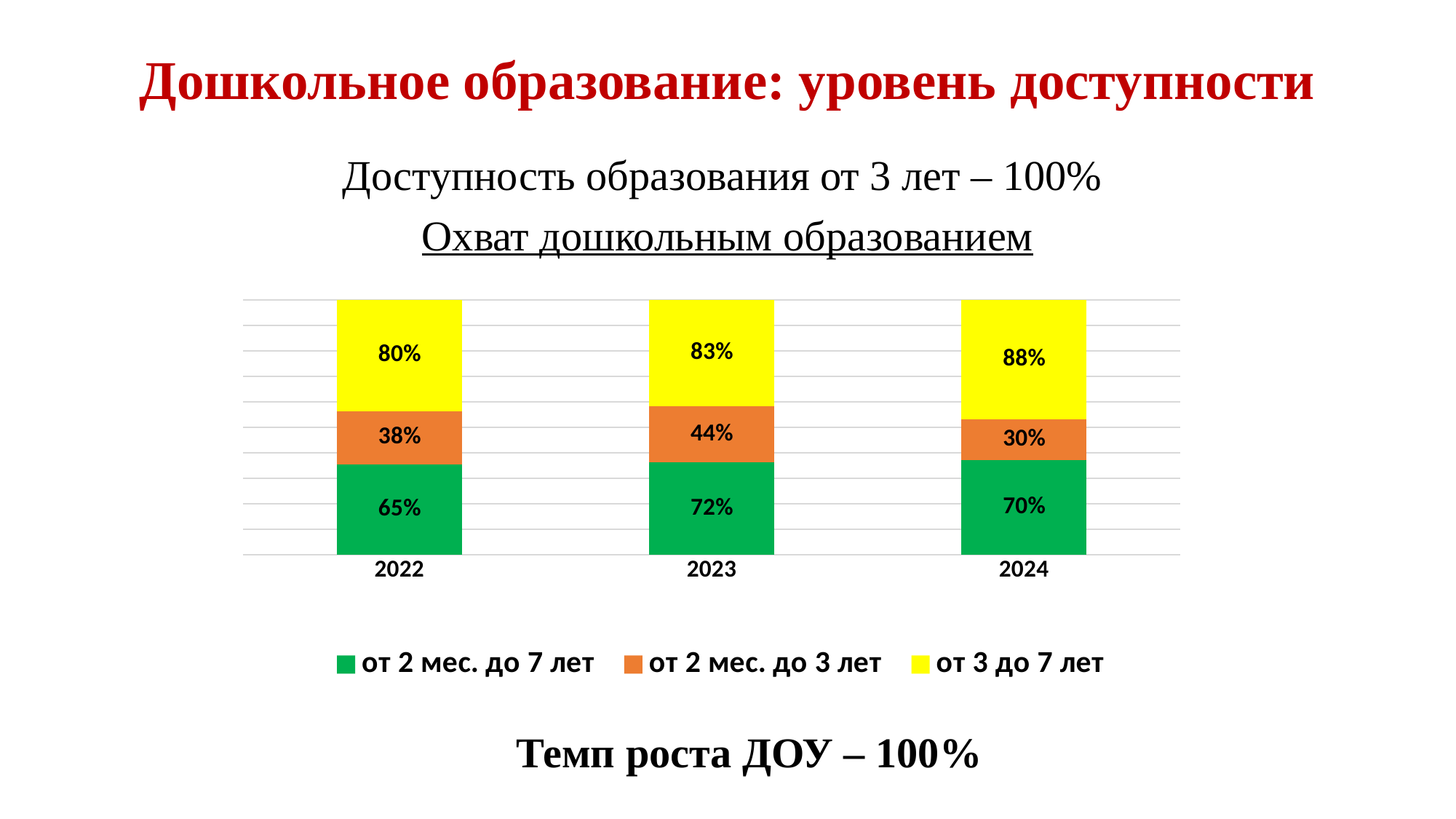
What is the value for "от 2 мес. до 3 лет" in 2023? 44% What is the value for "от 2 мес. до 3 лет" in 2024? 30% In which year is the value for "от 2 мес. до 3 лет" lowest? 2024 What is the difference between the "от 3 до 7 лет" values for 2024 and 2022? 8% What is the value for "от 2 мес. до 7 лет" in 2022? 65% What is the value for "от 3 до 7 лет" in 2024? 88% What kind of chart is shown on the slide? stacked bar chart How many years are shown on the x axis? 3 In which year is the value for "от 3 до 7 лет" highest? 2024 Does the value for "от 3 до 7 лет" rise or fall from 2022 to 2024? rise Which is larger: the "от 2 мес. до 7 лет" value for 2023 or for 2024? 2023 How many series does the legend list? 3